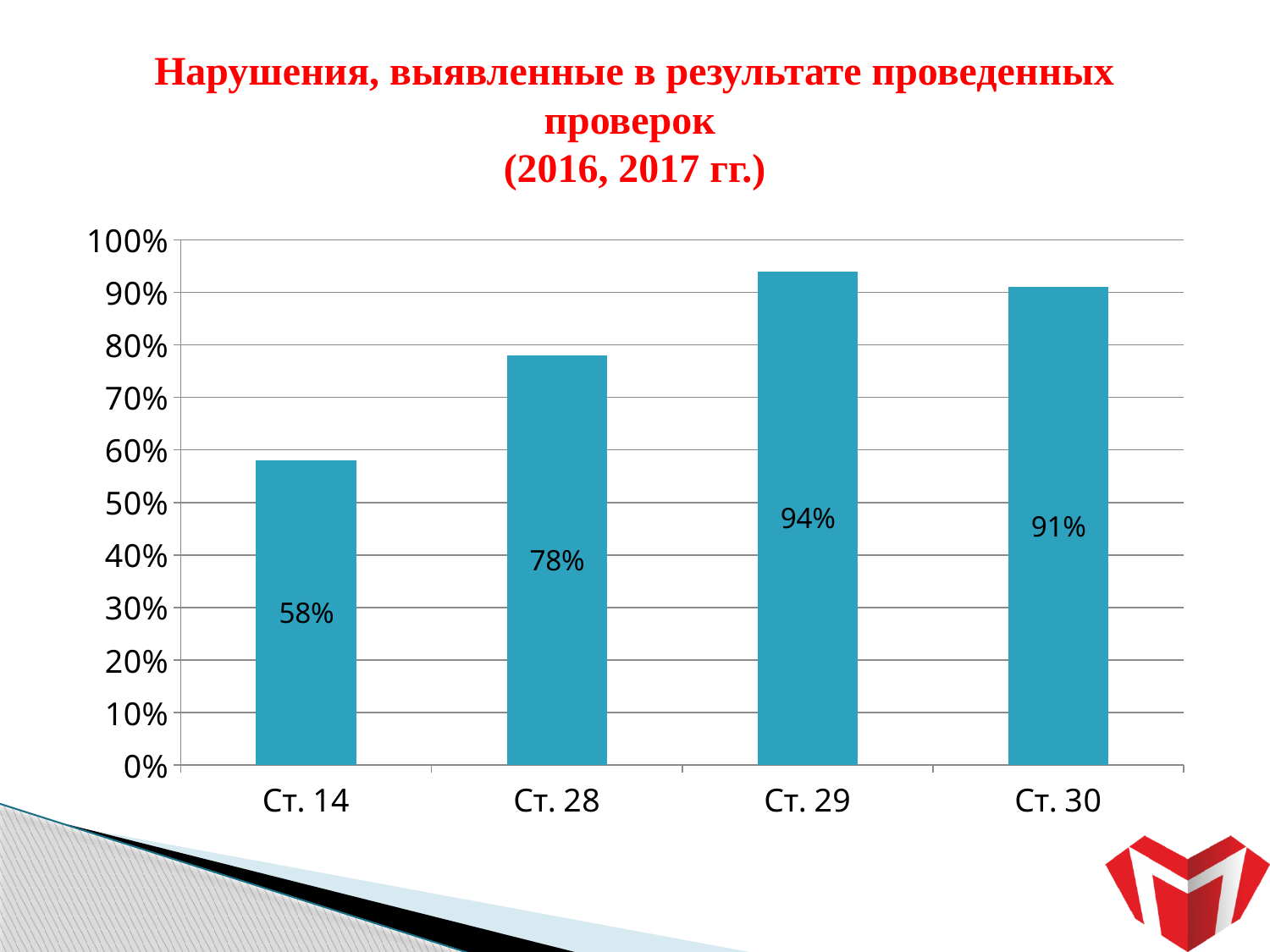
What is the value for Ст. 29? 94% Which category has the highest value? Ст. 29 What kind of chart is shown on the slide? bar chart Which is larger, the value for Ст. 28 or the value for Ст. 30? Ст. 30 Which category has the lowest value? Ст. 14 What is the value for Ст. 30? 91% What is the difference between the values for Ст. 29 and Ст. 14? 36% How many categories are shown on the x axis? 4 Is the value for Ст. 14 greater or less than 60%? less What is the value for Ст. 28? 78% What is the value for Ст. 14? 58% What is the difference between the values for Ст. 30 and Ст. 28? 13%